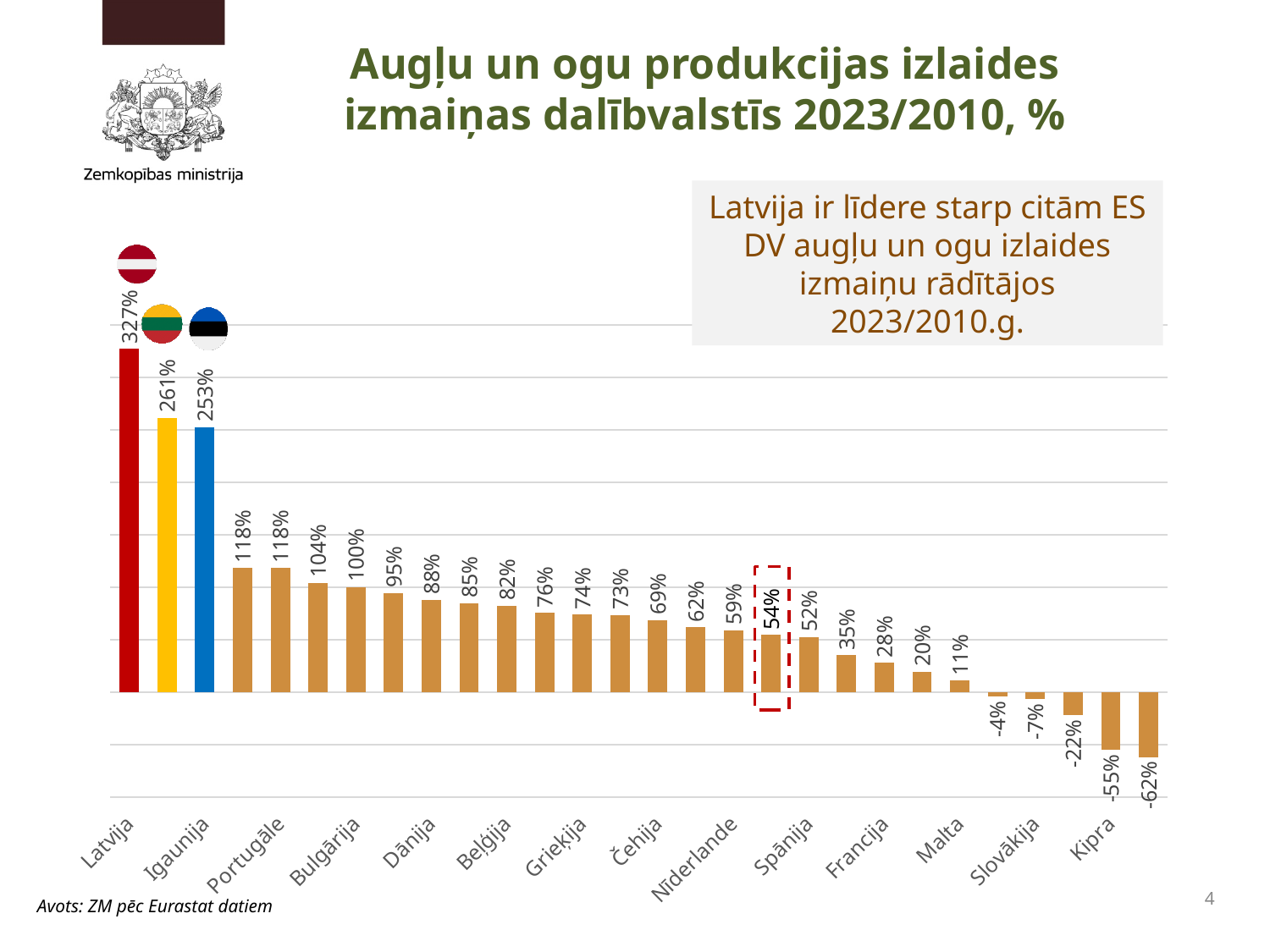
What kind of chart is shown on the slide? Bar chart Which country has the highest value in the chart? Latvija Which is larger, the value for Latvija or the value for Kipra? Latvija What is the value for Kipra? -55% What is the lowest value shown in the chart? -62% Do the values rise or fall from left to right along the x axis? Fall What is the value for Igaunija? 253% How many bars are plotted in the chart? 28 What value is highlighted by the red dashed box? 54% What is the value for Malta? 11% What is the value for Latvija? 327% What is the difference between the values for Latvija and Igaunija? 74 percentage points